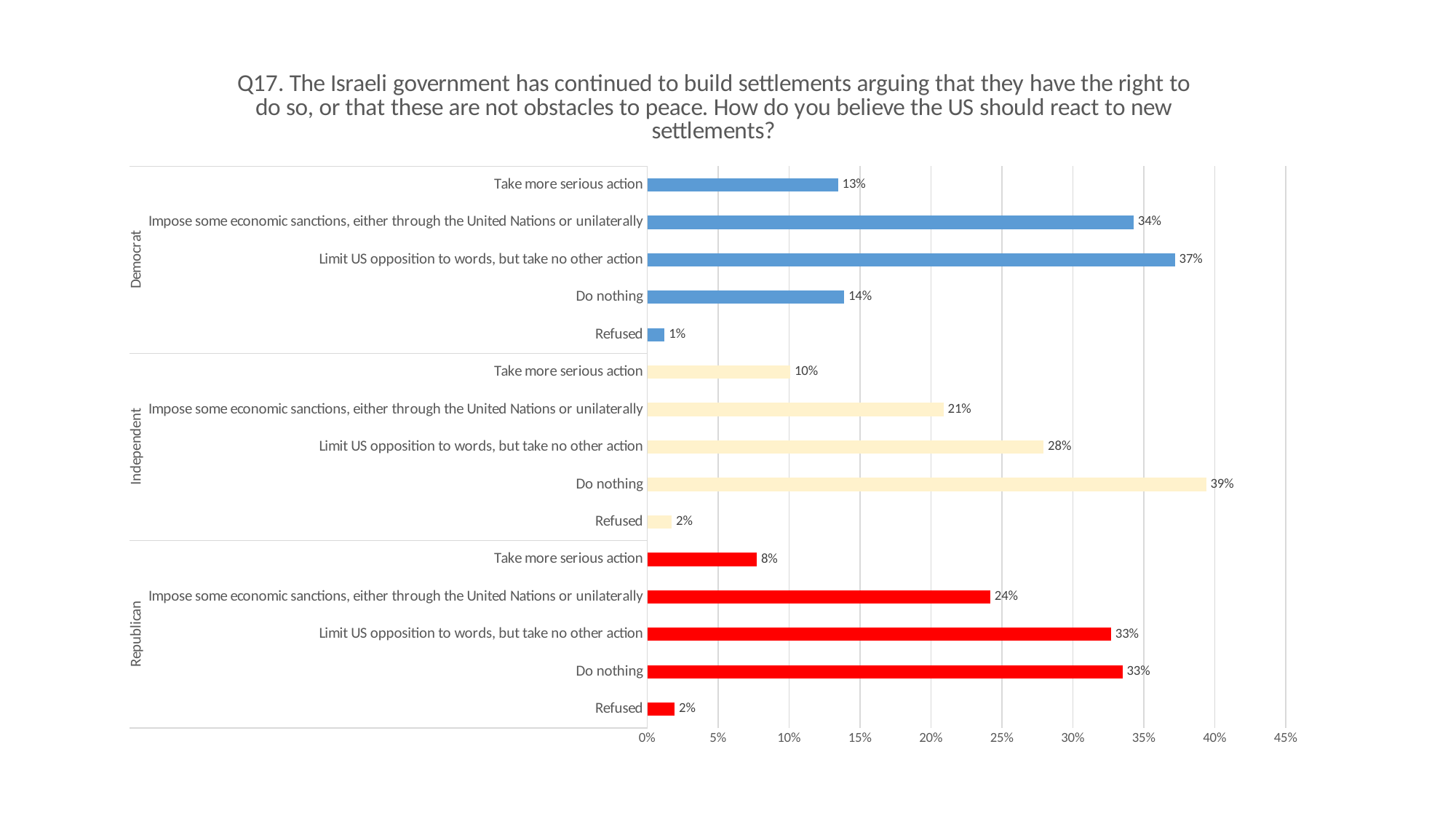
Which response has the highest value among Democrats? Limit US opposition to words, but take no other action What colour are the bars for the Republican group? Red How many response options are shown for each party group? 5 What percentage of Republicans chose "Impose some economic sanctions, either through the United Nations or unilaterally"? 24% What is the difference between the Independent and Democrat values for "Do nothing"? 25% What percentage of Independents chose "Do nothing"? 39% What kind of chart is shown on the slide? Bar chart Which response has the lowest value among Independents? Refused What percentage of Democrats chose "Limit US opposition to words, but take no other action"? 37% Is the Independent value for "Limit US opposition to words, but take no other action" greater or less than 30%? less Which is larger: the Independent value for "Impose some economic sanctions" or the Republican value for "Impose some economic sanctions"? Republican What is the difference between the Democrat and Republican values for "Take more serious action"? 5%